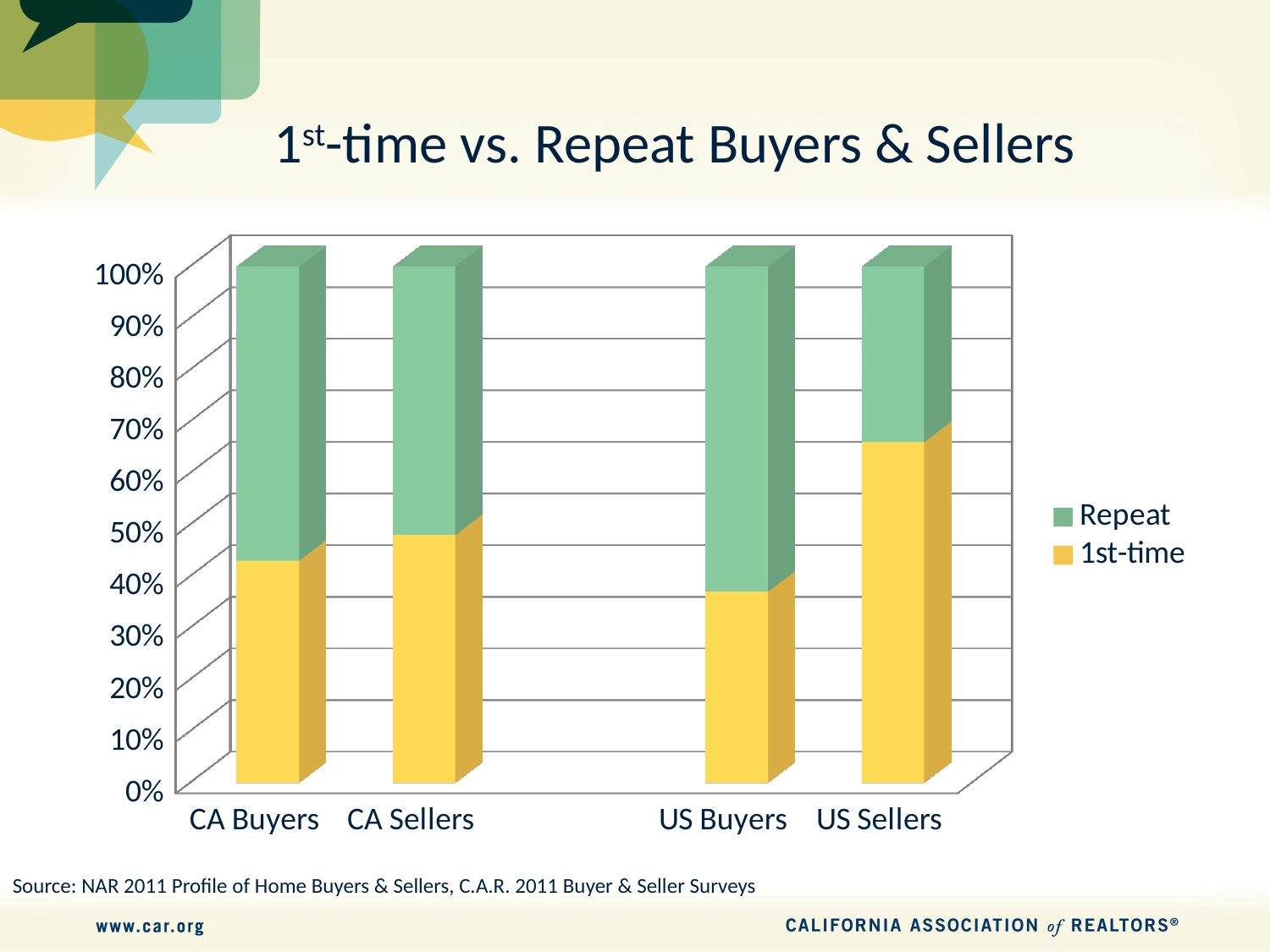
What are the two series listed in the chart's legend? Repeat and 1st-time How many series does the chart's legend list? 2 Which colour represents the 1st-time series in the chart? Yellow Which has the larger 1st-time share, CA Buyers or US Sellers? US Sellers Which category has the smallest 1st-time share? US Buyers How many categories are shown on the x axis of the chart? 4 Is the 1st-time share for US Buyers greater or less than 50%? less Which category has the largest 1st-time share? US Sellers Is the 1st-time share for CA Buyers greater or less than 50%? less What kind of chart is shown on the slide? Stacked bar chart Which category has the largest Repeat share? US Buyers Is the 1st-time share for US Sellers greater or less than 60%? greater